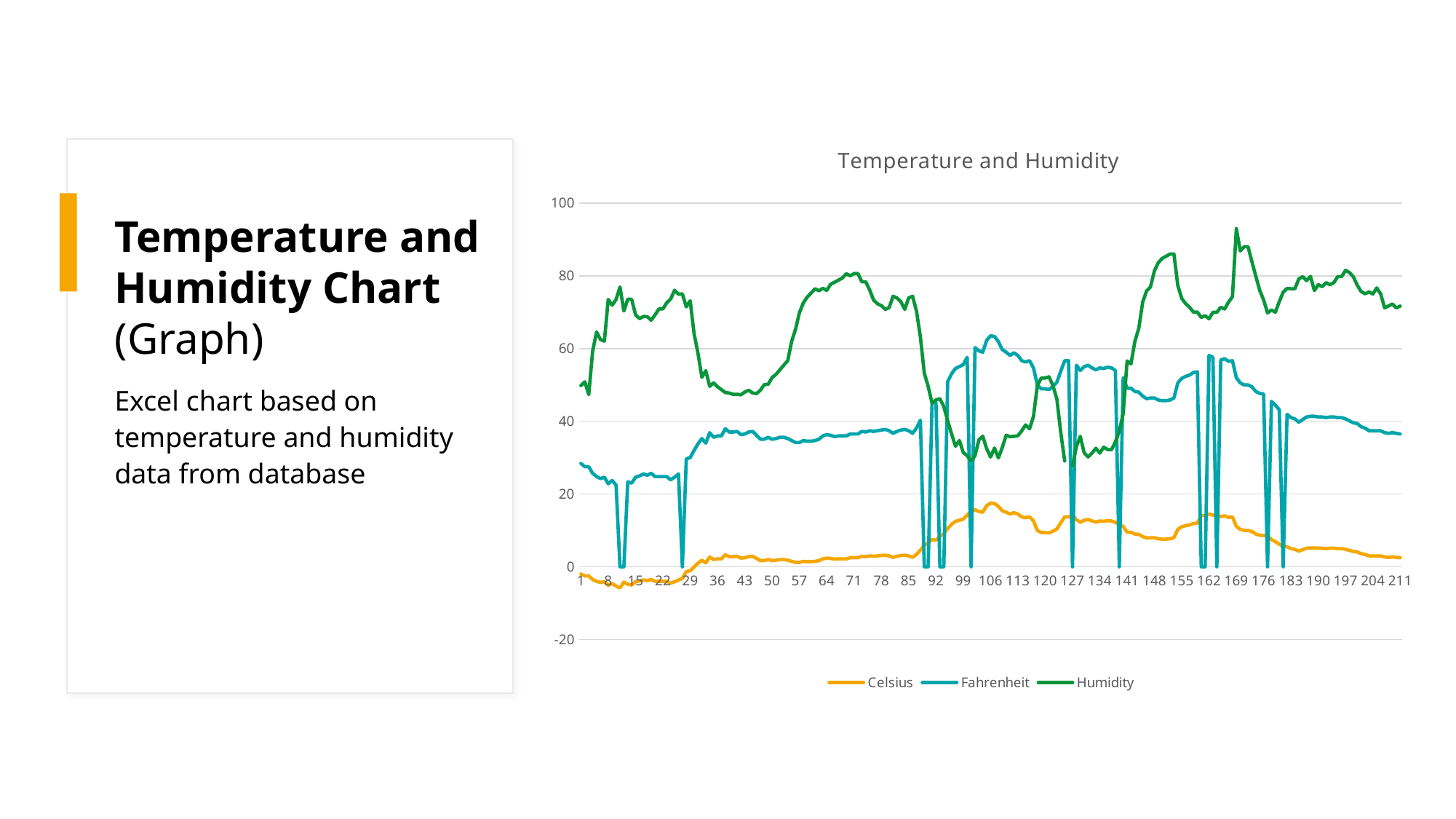
Is the Fahrenheit value at x = 1 greater or less than 20? greater At x = 43, which is larger: Humidity or Fahrenheit? Humidity Which series reaches the highest value anywhere on the chart? Humidity At x = 106, which is larger: Fahrenheit or Humidity? Fahrenheit What is the last label on the x axis? 211 What kind of chart is shown on the slide? line chart Is the Celsius value at x = 106 greater or less than 20? less How many series does the chart legend list? 3 Is the Humidity value at x = 43 greater or less than 60? less Which series is drawn in green in the chart? Humidity What is the title of the chart? Temperature and Humidity